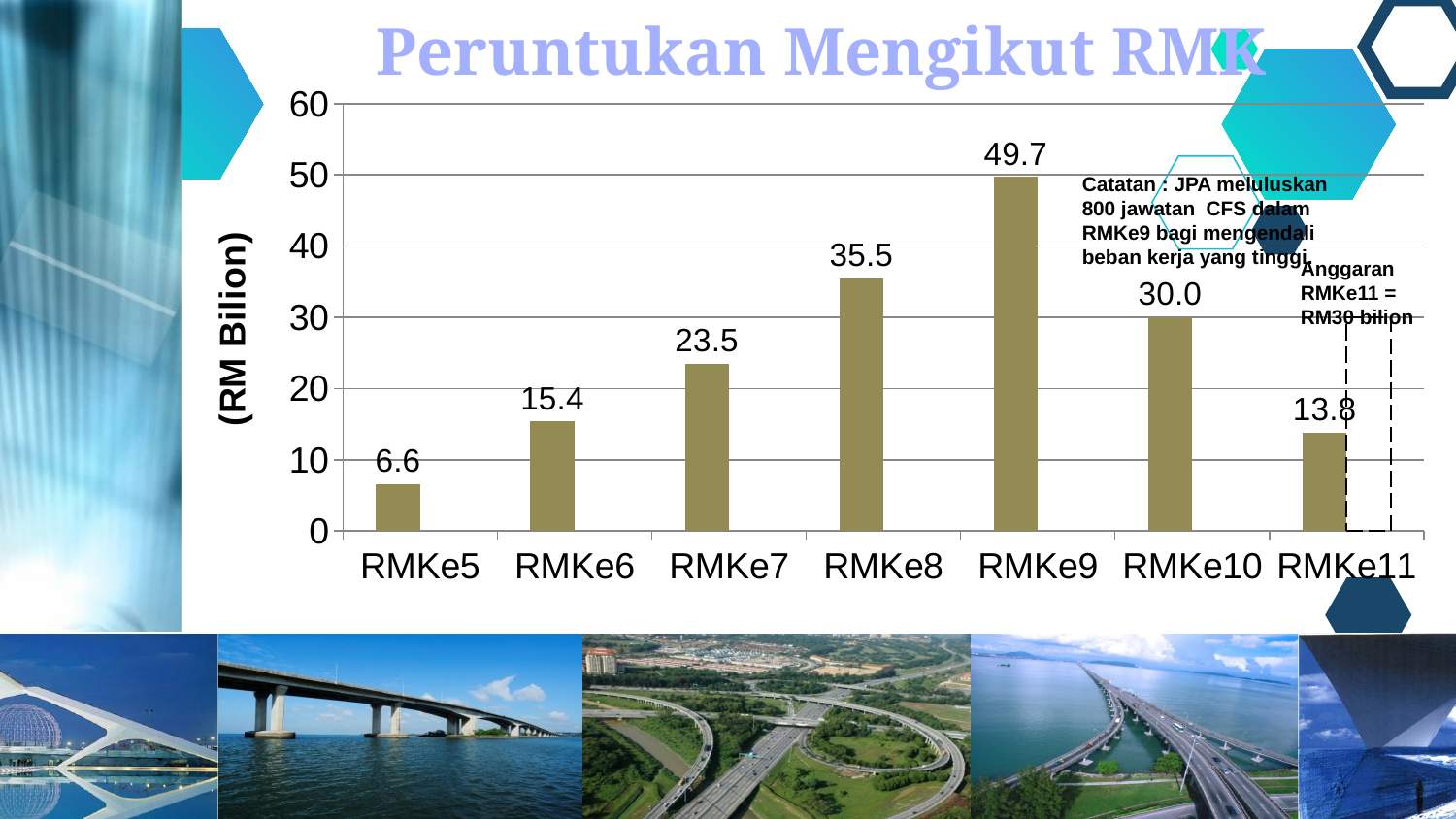
What is the value for RMKe11? 13.8 Which category has the lowest value? RMKe5 How many categories are shown on the x axis? 7 What is the difference between the values for RMKe10 and RMKe11? 16.2 Do the values rise or fall from RMKe5 to RMKe9? rise What kind of chart is shown? bar chart Which category has the highest value? RMKe9 What is the value for RMKe5? 6.6 What is the title of the chart? Peruntukan Mengikut RMK What is the value for RMKe9? 49.7 Which is larger, the value for RMKe7 or the value for RMKe10? RMKe10 What is the difference between the values for RMKe9 and RMKe8? 14.2